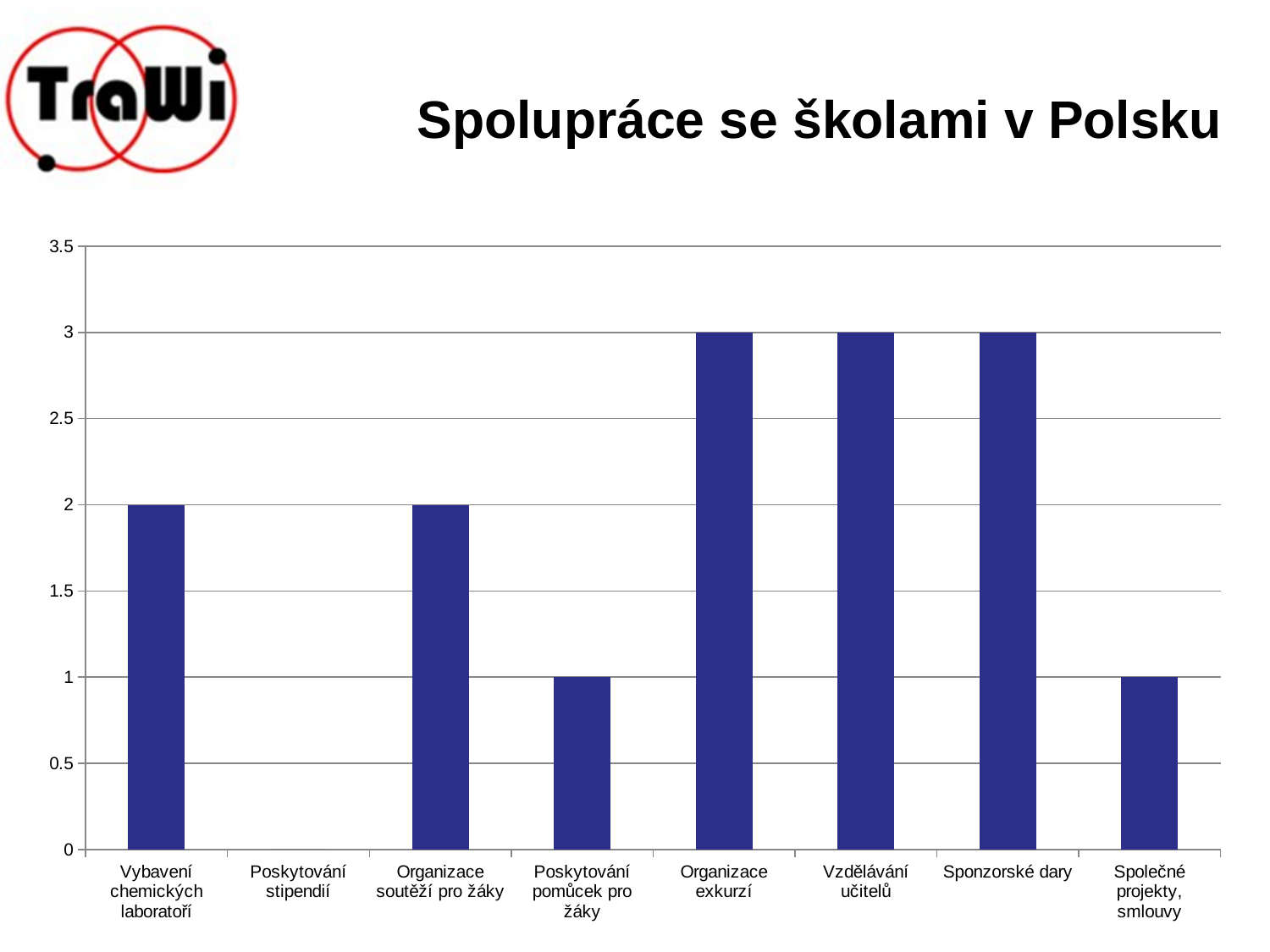
What is the value for Organizace exkurzí? 3 What is the highest value shown on the y axis? 3.5 Which category has the lowest value? Poskytování stipendií What kind of chart is shown on the slide? bar chart What is the value for Vybavení chemických laboratoří? 2 What is the title of the slide? Spolupráce se školami v Polsku How many categories are shown on the x axis? 8 What is the value for Poskytování stipendií? 0 What is the difference between the values for Sponzorské dary and Společné projekty, smlouvy? 2 Which is larger, the value for Organizace soutěží pro žáky or the value for Vzdělávání učitelů? Vzdělávání učitelů Is the value for Sponzorské dary greater or less than 2.5? greater What is the value for Poskytování pomůcek pro žáky? 1